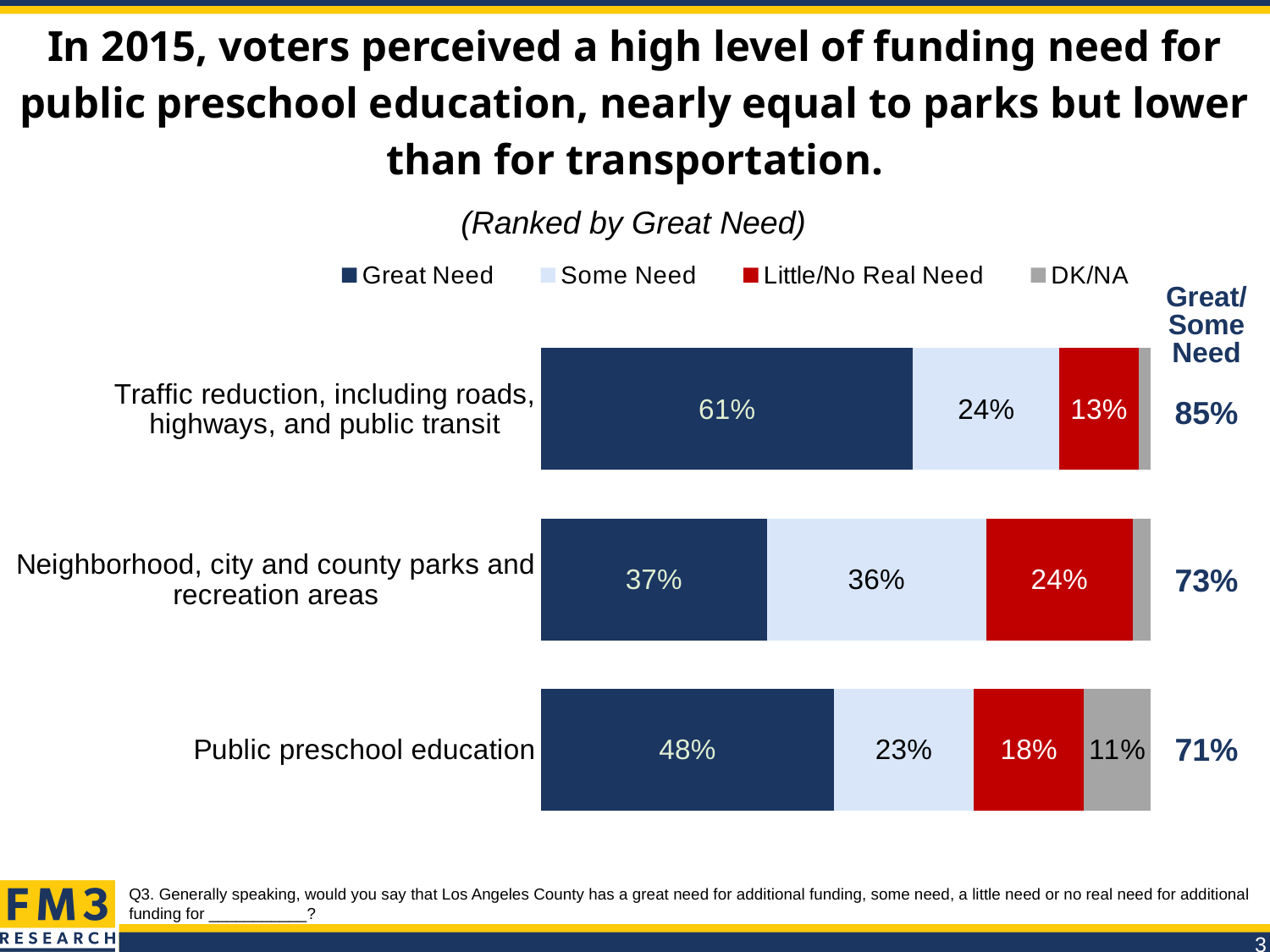
Which category has the highest Great Need percentage? Traffic reduction, including roads, highways, and public transit What is the DK/NA percentage for public preschool education? 11% What percentage of voters said there is a Great Need for funding for traffic reduction, including roads, highways, and public transit? 61% How many series does the legend list? 4 What percentage of voters said there is Little/No Real Need for funding for public preschool education? 18% What kind of chart is shown on the slide? Stacked bar chart What is the combined Great/Some Need percentage shown for neighborhood, city and county parks and recreation areas? 73% Which category has the lowest Great Need percentage? Neighborhood, city and county parks and recreation areas What percentage of voters said there is Some Need for funding for neighborhood, city and county parks and recreation areas? 36% Which has a larger Little/No Real Need percentage: parks and recreation areas or public preschool education? Neighborhood, city and county parks and recreation areas How many categories are shown in the chart? 3 What is the difference between the Great Need percentage for traffic reduction and the Great Need percentage for public preschool education? 13%